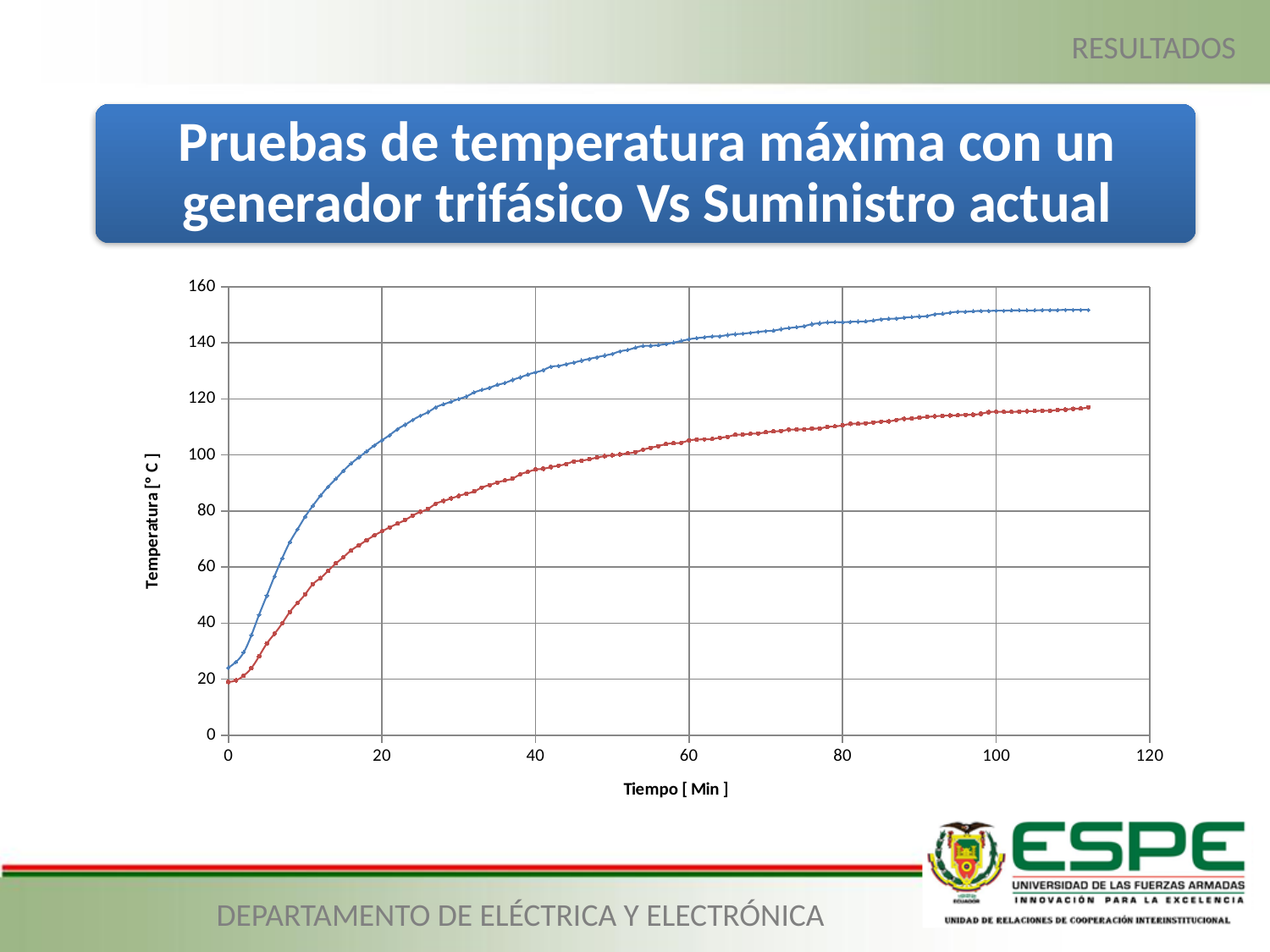
At 60 minutes, which line has the higher temperature, blue or red? blue Do the temperature values rise or fall as time increases along the x axis? rise Is the value of the blue line at 100 minutes greater or less than 140? greater Is the value of the red line at 40 minutes greater or less than 100? less What is the title of the horizontal axis? Tiempo [ Min ] What kind of chart is shown on the slide? line chart What is the title of the vertical axis? Temperatura [° C ] How many lines (series) are plotted on the chart? 2 Is the value of the red line at 100 minutes greater or less than 100? greater Which line reaches the higher temperature, the blue line or the red line? the blue line